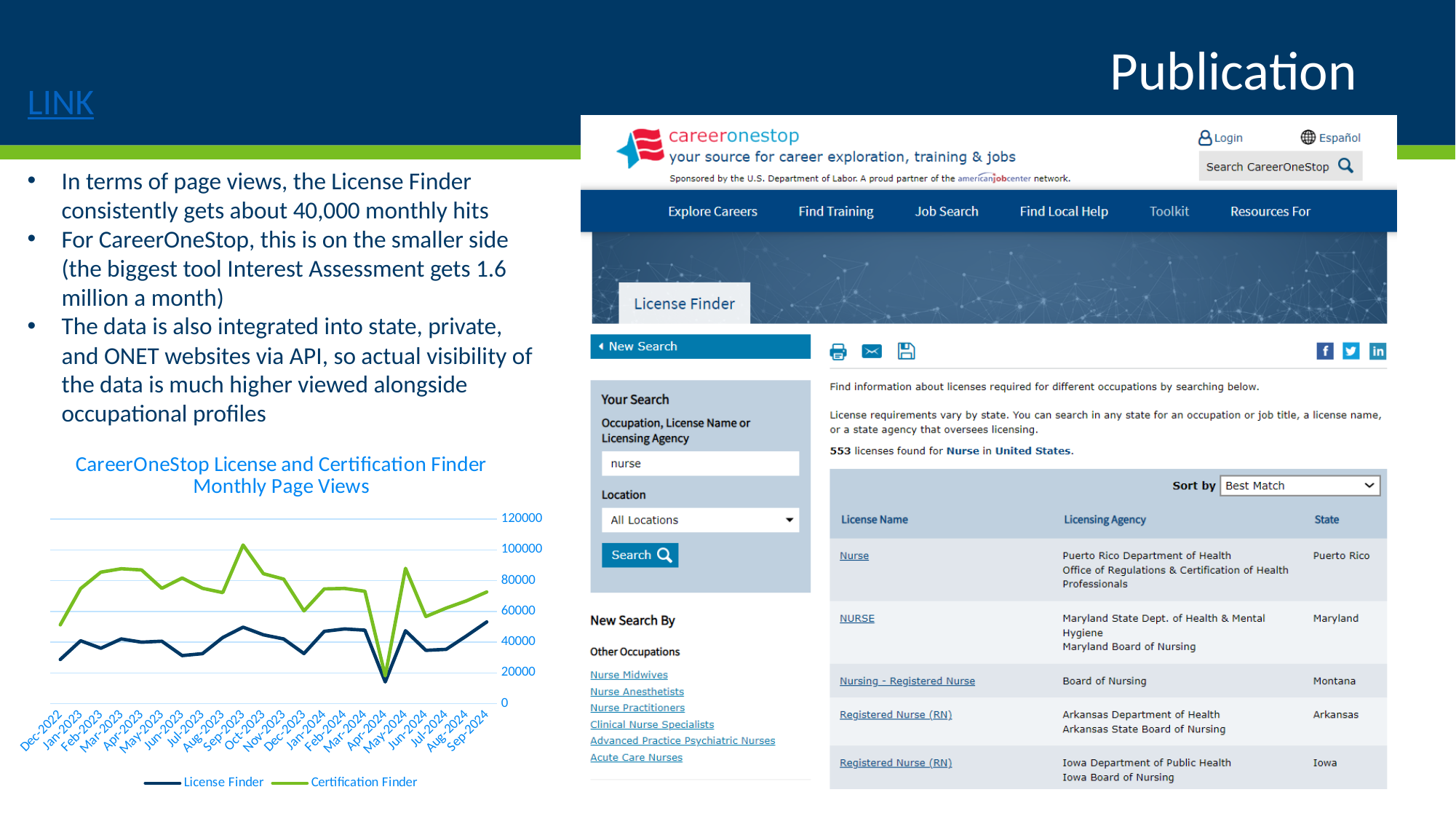
In which month does the License Finder series reach its lowest value? Apr-2024 What kind of chart is shown on the slide? line chart Is the Certification Finder value for Sep-2023 greater or less than 80000? greater Which series is drawn in green in the chart? Certification Finder Is the License Finder value for Dec-2022 greater or less than 20000? greater How many series does the chart legend list? 2 Is the License Finder value for Apr-2024 greater or less than 20000? less In which month does the Certification Finder series reach its highest value? Sep-2023 Which series has the lower values across almost all months, License Finder or Certification Finder? License Finder In Sep-2023, which series has the higher value, License Finder or Certification Finder? Certification Finder How many months are plotted along the x axis of the chart? 22 What is the title of the chart? CareerOneStop License and Certification Finder Monthly Page Views